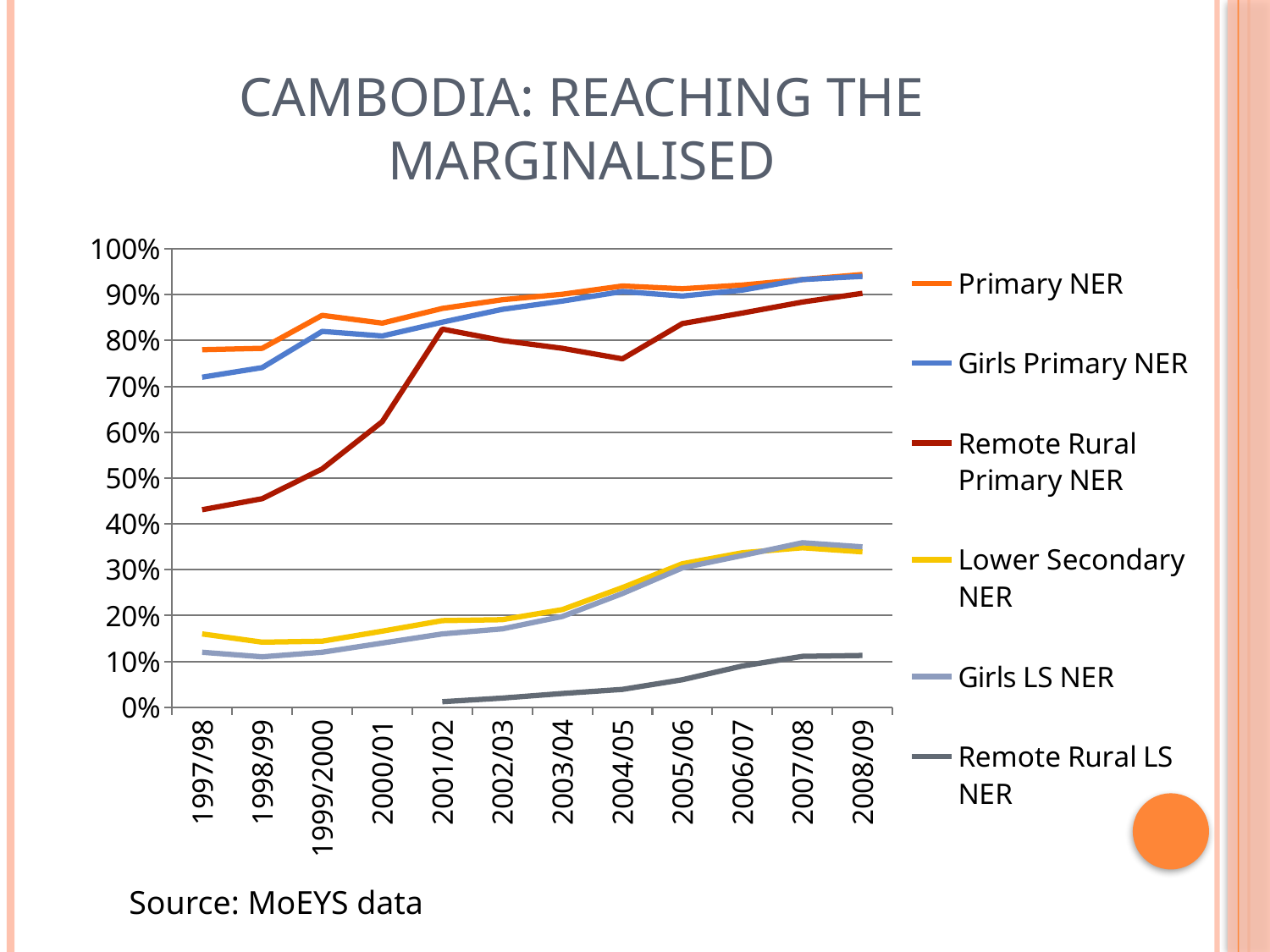
How many series does the legend list? 6 Which series has the lowest value in 2008/09? Remote Rural LS NER Is the value for Remote Rural LS NER in 2008/09 greater or less than 20%? less In 1997/98, which is larger: Lower Secondary NER or Girls LS NER? Lower Secondary NER Is the value for Primary NER in 2008/09 greater or less than 90%? greater Is the value for Remote Rural Primary NER in 1997/98 greater or less than 40%? greater Does Remote Rural Primary NER rise or fall between 1997/98 and 2001/02? rise What kind of chart is shown on the slide? line chart How many school years are shown on the x axis? 12 Which series has the highest value in 1997/98? Primary NER What is the title of the slide containing the chart? CAMBODIA: REACHING THE MARGINALISED